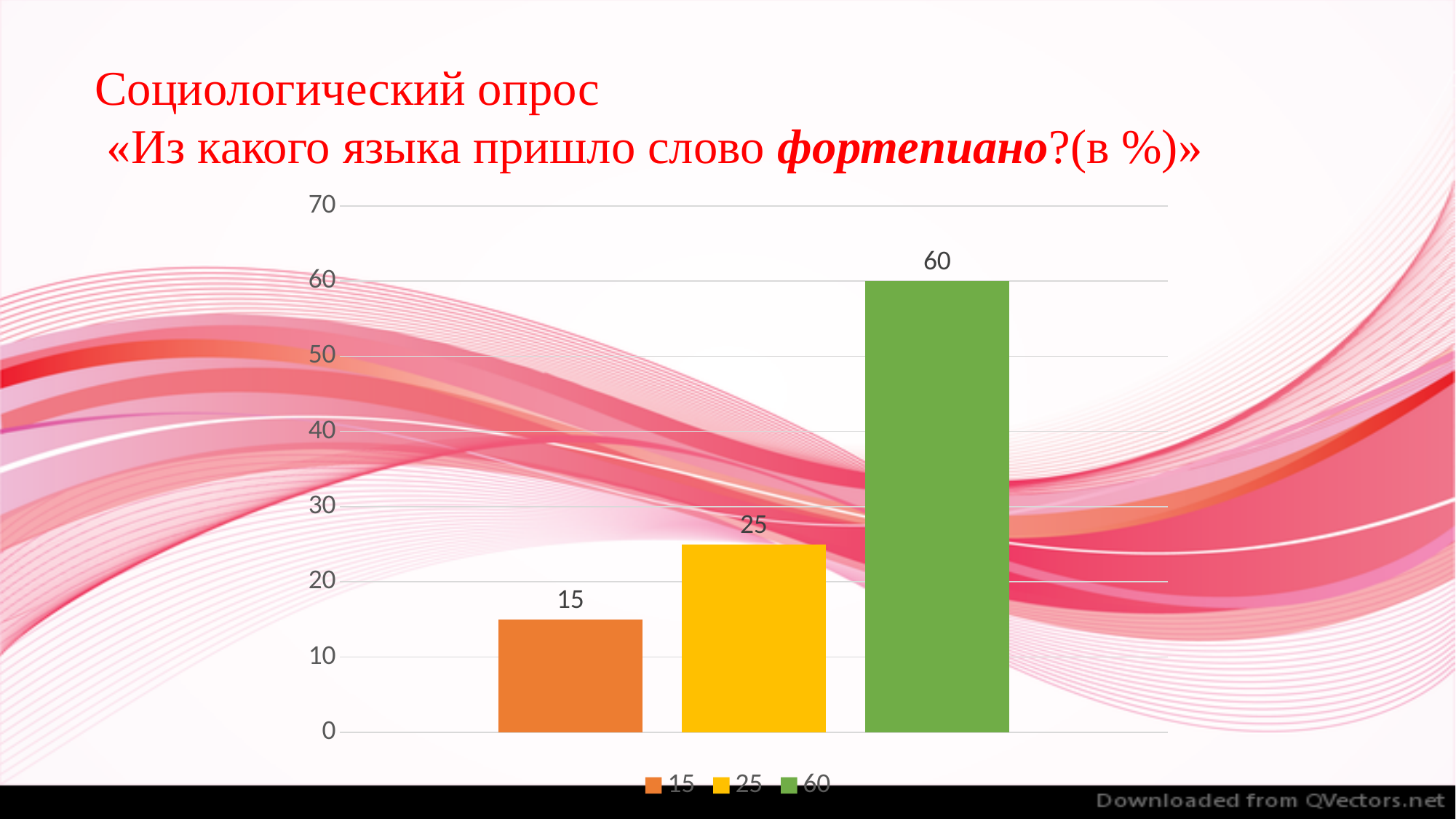
Which bar has the lowest value? the orange bar (15) What is the value of the yellow bar? 25 What is the difference between the green bar and the yellow bar? 35 How many bars are plotted in the chart? 3 Which bar has the highest value? the green bar (60) What type of chart is shown on the slide? bar chart What is the maximum value shown on the vertical axis? 70 How many entries does the chart legend list? 3 Which is larger, the yellow bar or the orange bar? the yellow bar What is the value of the green bar? 60 What is the value of the orange bar? 15 What is the difference between the yellow bar and the orange bar? 10